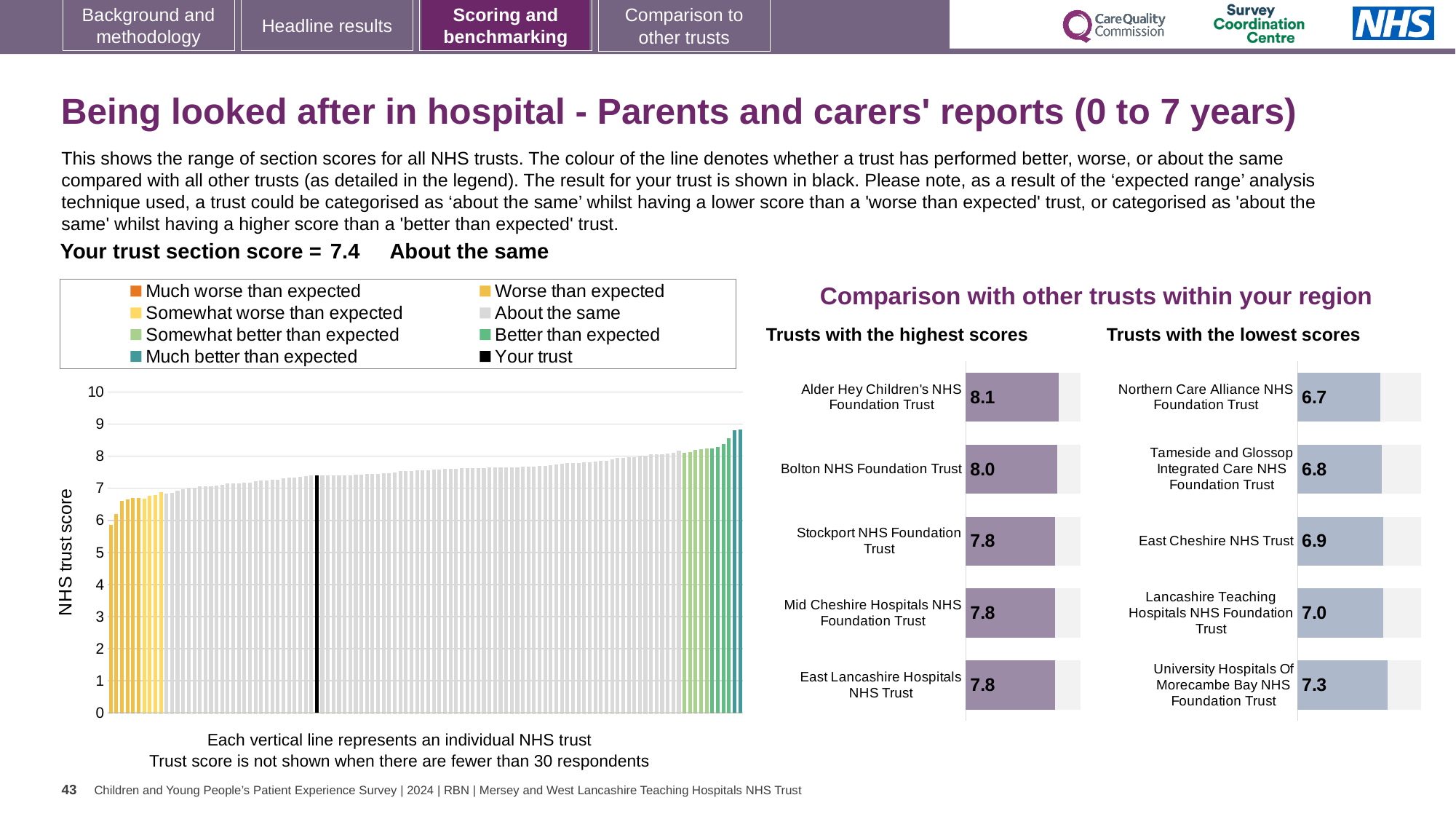
In the 'NHS trust score' chart on the left, do the bar values rise or fall from left to right? Rise Which has a higher score: Bolton NHS Foundation Trust in the 'highest scores' chart or Lancashire Teaching Hospitals NHS Foundation Trust in the 'lowest scores' chart? Bolton NHS Foundation Trust In the 'NHS trust score' chart on the left, is the value for the black 'Your trust' bar greater or less than 7? greater In the 'Trusts with the highest scores' chart, which trust has the highest score? Alder Hey Children's NHS Foundation Trust How many entries does the legend of the 'NHS trust score' chart on the left list? 8 In the 'Trusts with the lowest scores' chart, what is the score for East Cheshire NHS Trust? 6.9 How many trusts are shown in the 'Trusts with the lowest scores' chart? 5 What kind of chart is the 'NHS trust score' chart on the left of the slide? Bar chart In the 'Trusts with the highest scores' chart, what is the difference between the scores of Alder Hey Children's NHS Foundation Trust and Stockport NHS Foundation Trust? 0.3 In the 'Trusts with the highest scores' chart, what is the score for Alder Hey Children's NHS Foundation Trust? 8.1 In the 'Trusts with the lowest scores' chart, which trust has the lowest score? Northern Care Alliance NHS Foundation Trust In the 'Trusts with the lowest scores' chart, what is the difference between the scores of University Hospitals Of Morecambe Bay NHS Foundation Trust and Northern Care Alliance NHS Foundation Trust? 0.6